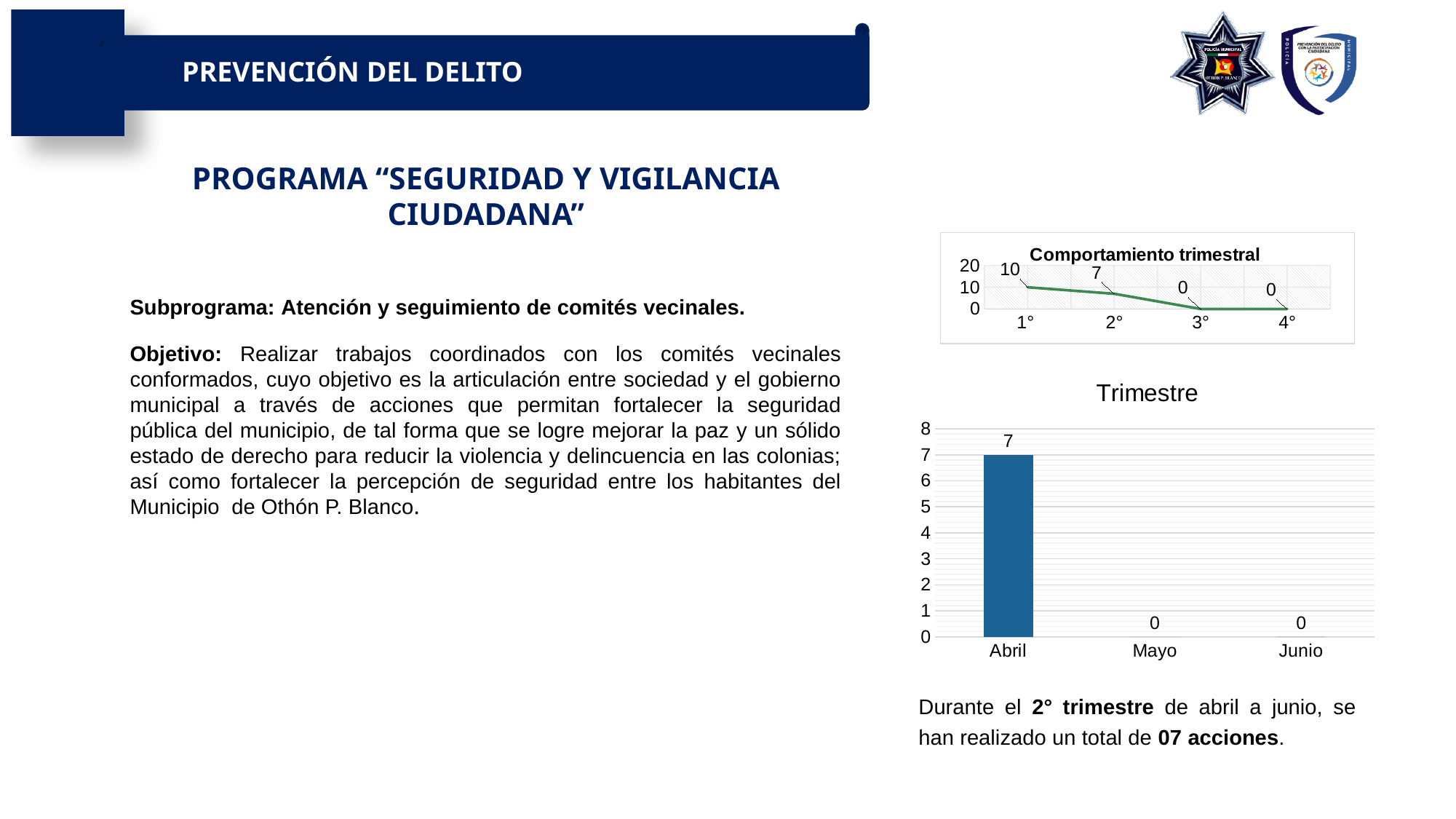
How many categories are shown in the 'Trimestre' chart? 3 In the 'Comportamiento trimestral' chart, what is the difference between the values for 1° and 2°? 3 In the 'Trimestre' chart, what is the value for Abril? 7 In the 'Comportamiento trimestral' chart, what is the value for 1°? 10 In the 'Comportamiento trimestral' chart, do the values rise or fall from 1° to 4°? fall In the 'Comportamiento trimestral' chart, which quarter has the highest value? 1° What kind of chart is the 'Trimestre' chart? bar chart In the 'Comportamiento trimestral' chart, what is the value for 2°? 7 How many data points are plotted in the 'Comportamiento trimestral' chart? 4 What kind of chart is the 'Comportamiento trimestral' chart? line chart In the 'Trimestre' chart, which month has the highest value? Abril In the 'Trimestre' chart, what is the value for Mayo? 0